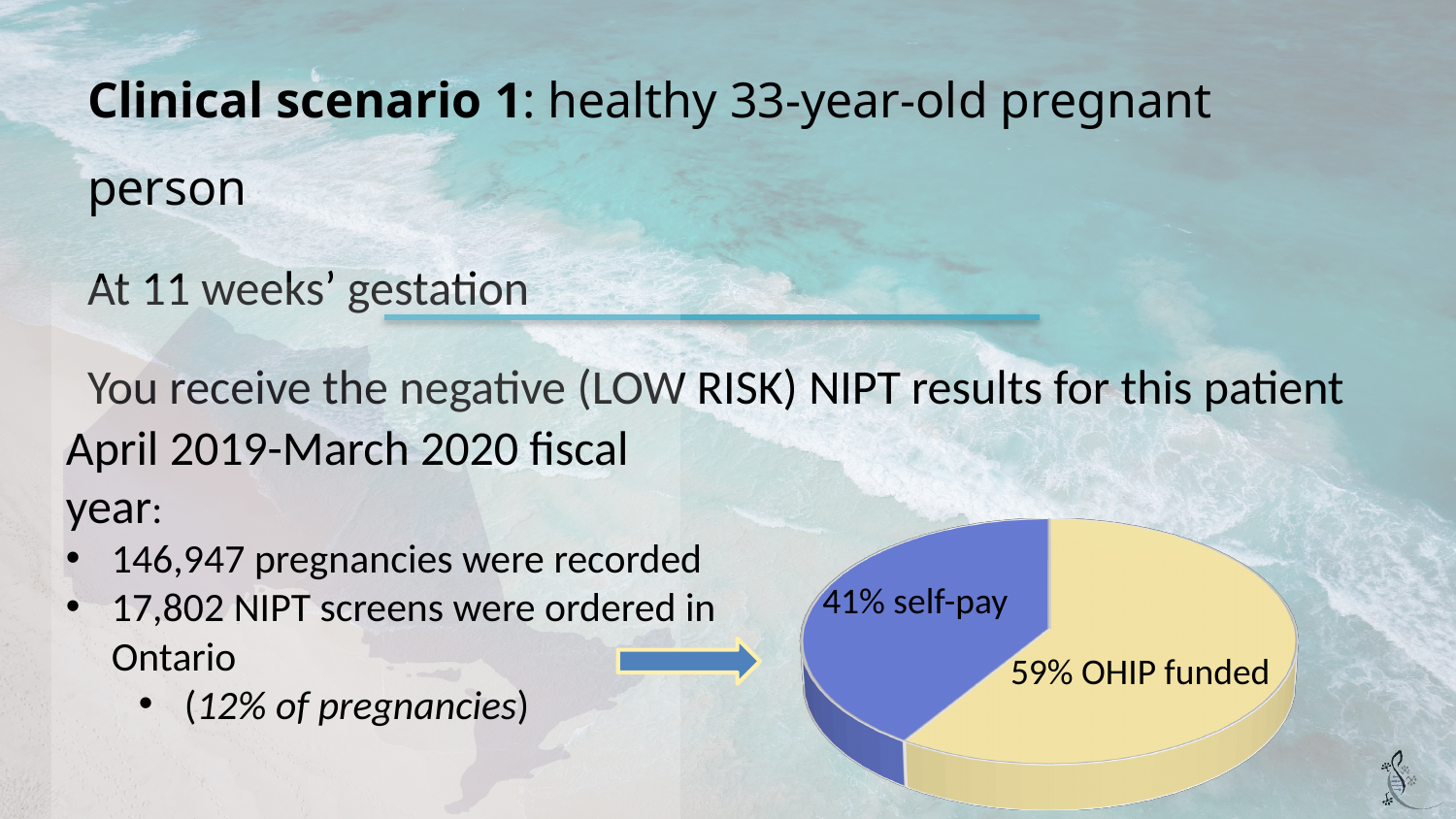
Which slice of the pie is the smallest? self-pay What share of the pie is labelled self-pay? 41% What colour is the OHIP funded slice of the pie? yellow What share of the pie is labelled OHIP funded? 59% What colour is the self-pay slice of the pie? blue What kind of chart is shown on the slide? pie chart How many slices does the pie chart have? 2 Which slice of the pie is larger, self-pay or OHIP funded? OHIP funded Which slice of the pie is the largest? OHIP funded What is the difference in percentage points between the OHIP funded and self-pay slices? 18